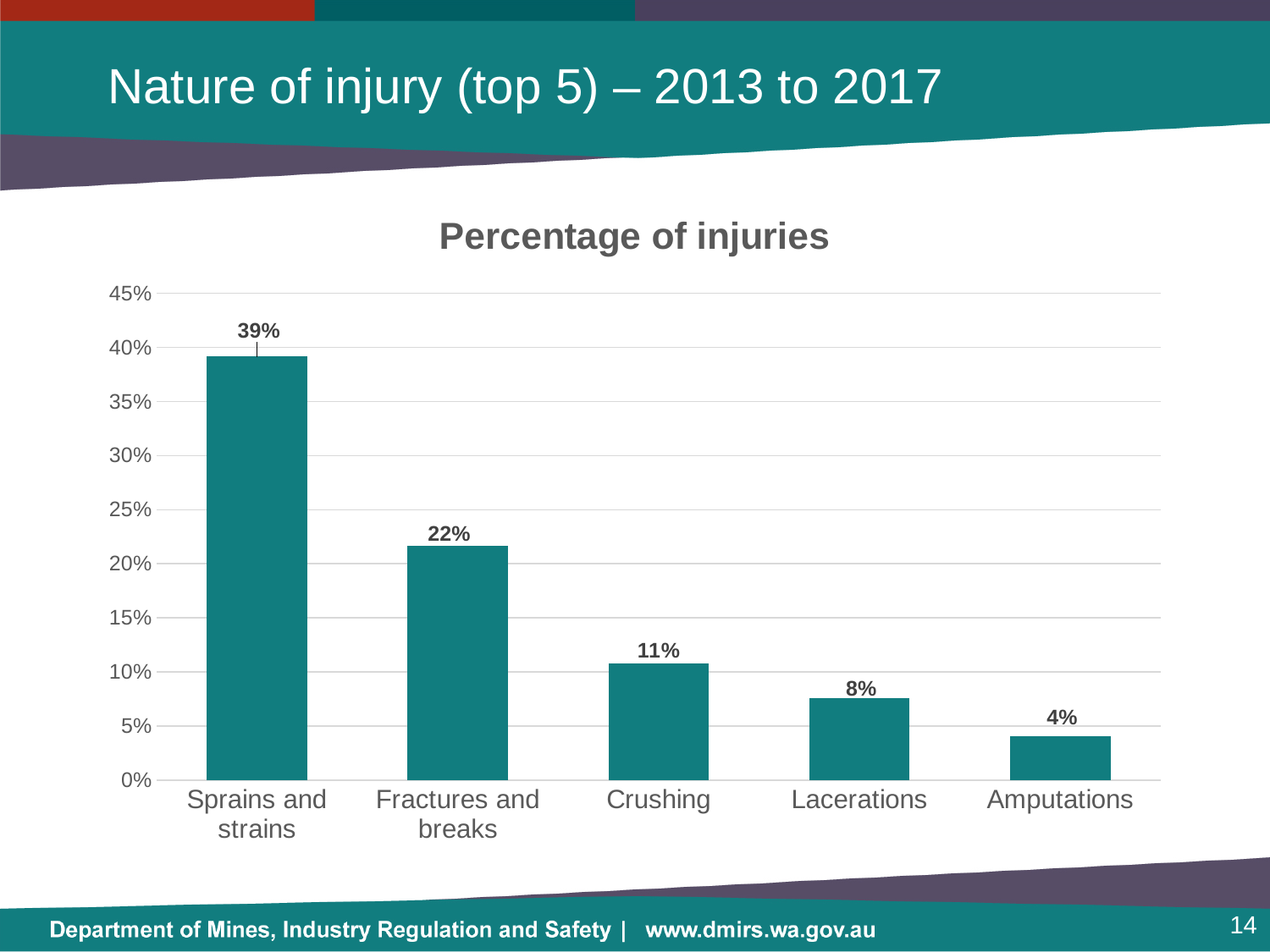
What is the value for Fractures and breaks? 22% Which category has the lowest percentage of injuries? Amputations What is the value for Sprains and strains? 39% What is the value for Crushing? 11% What is the value for Amputations? 4% What kind of chart is shown on the slide? Bar chart Which is larger, the value for Crushing or the value for Lacerations? Crushing What is the title of the chart? Percentage of injuries What is the value for Lacerations? 8% What is the difference between the values for Sprains and strains and Fractures and breaks? 17% How many categories are shown on the chart? 5 Which category has the highest percentage of injuries? Sprains and strains